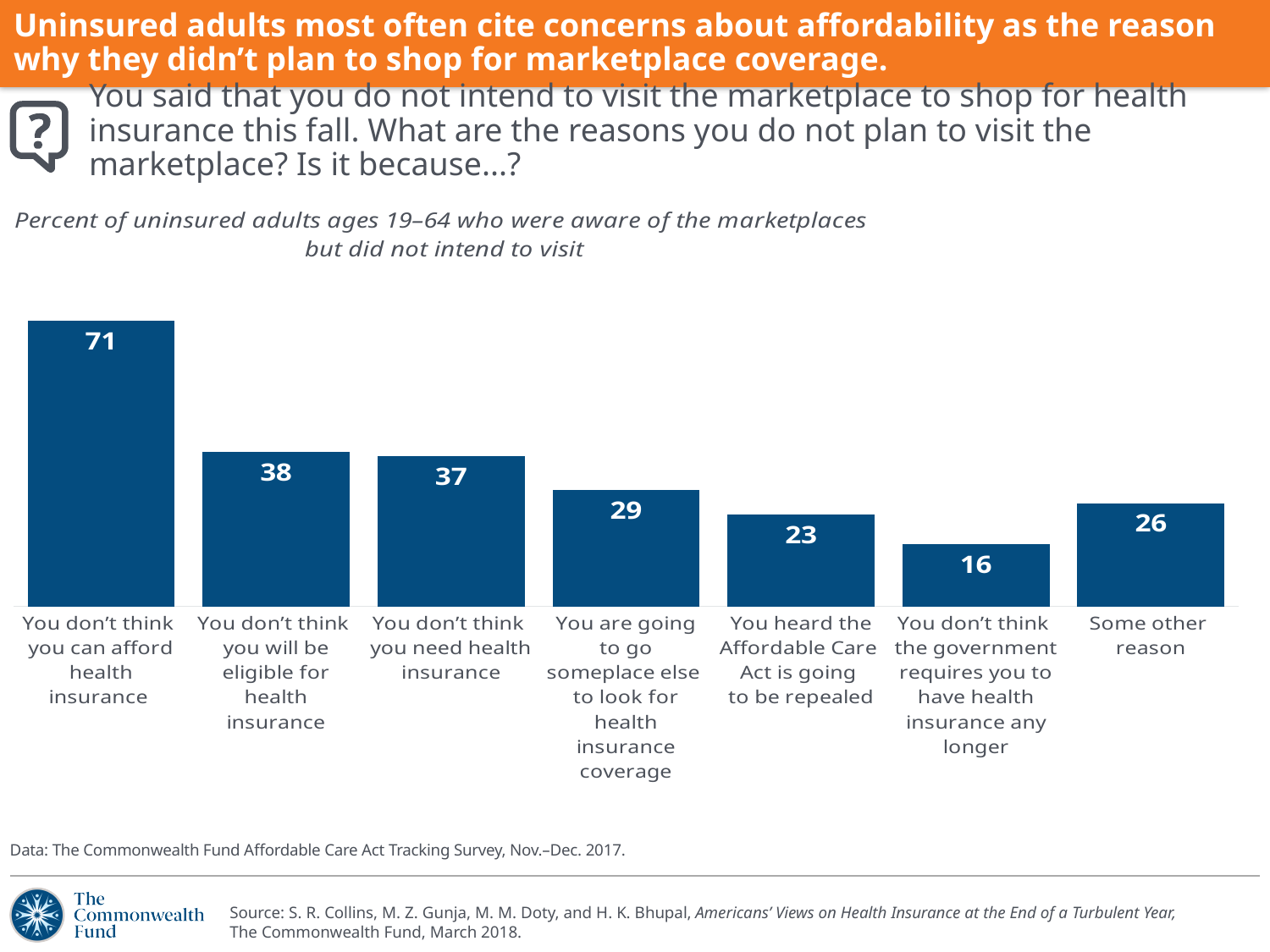
How many reasons (categories) are shown in the chart? 7 What kind of chart is shown on the slide? Bar chart What is the value for 'You don't think you need health insurance'? 37 What is the difference between the value for 'You are going to go someplace else to look for health insurance coverage' and 'You don't think the government requires you to have health insurance any longer'? 13 Which is larger: the value for 'Some other reason' or the value for 'You heard the Affordable Care Act is going to be repealed'? Some other reason Which reason has the lowest value? You don't think the government requires you to have health insurance any longer What percent of uninsured adults said they don't think they can afford health insurance? 71 Which reason has the highest value? You don't think you can afford health insurance What is the value for 'Some other reason'? 26 What is the difference between the value for 'You don't think you can afford health insurance' and 'You don't think you will be eligible for health insurance'? 33 What is the value for 'You heard the Affordable Care Act is going to be repealed'? 23 Which is larger: the value for 'You don't think you will be eligible for health insurance' or 'You are going to go someplace else to look for health insurance coverage'? You don't think you will be eligible for health insurance